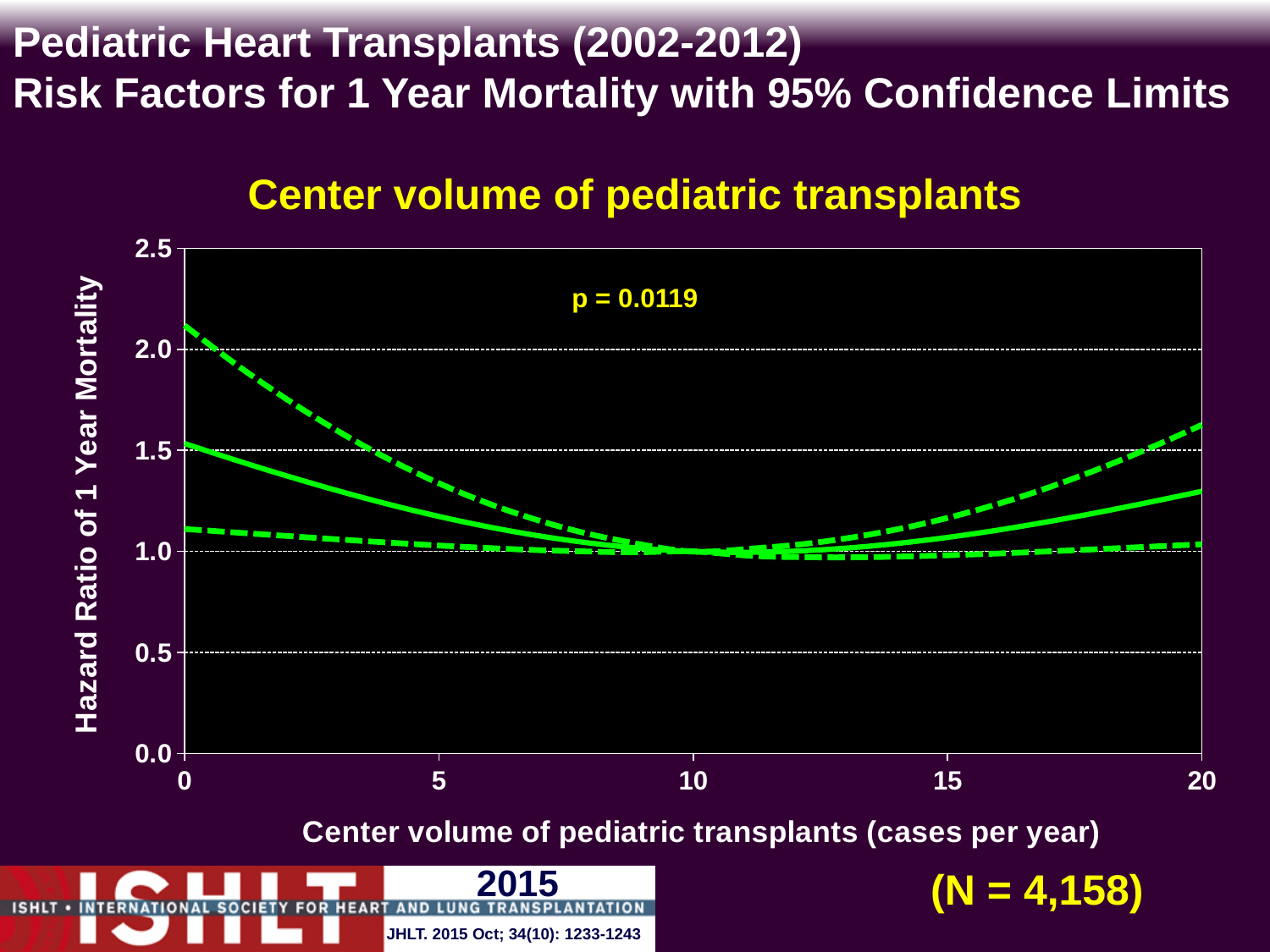
Is the value of the upper dashed line at a center volume of 20 cases per year greater or less than 1.5? greater How many lines are plotted on the chart? 3 What is the label of the y-axis? Hazard Ratio of 1 Year Mortality Does the solid line rise or fall as center volume increases from 0 to 10 cases per year? fall Does the solid line rise or fall as center volume increases from 10 to 20 cases per year? rise What is the title of the chart? Center volume of pediatric transplants Is the value of the upper dashed line at a center volume of 5 cases per year greater or less than 2.0? less Is the value of the solid line at a center volume of 20 cases per year greater or less than 1.0? greater What kind of chart is shown on the slide? line chart What p-value is printed on the chart? p = 0.0119 What sample size (N) is shown on the slide? N = 4,158